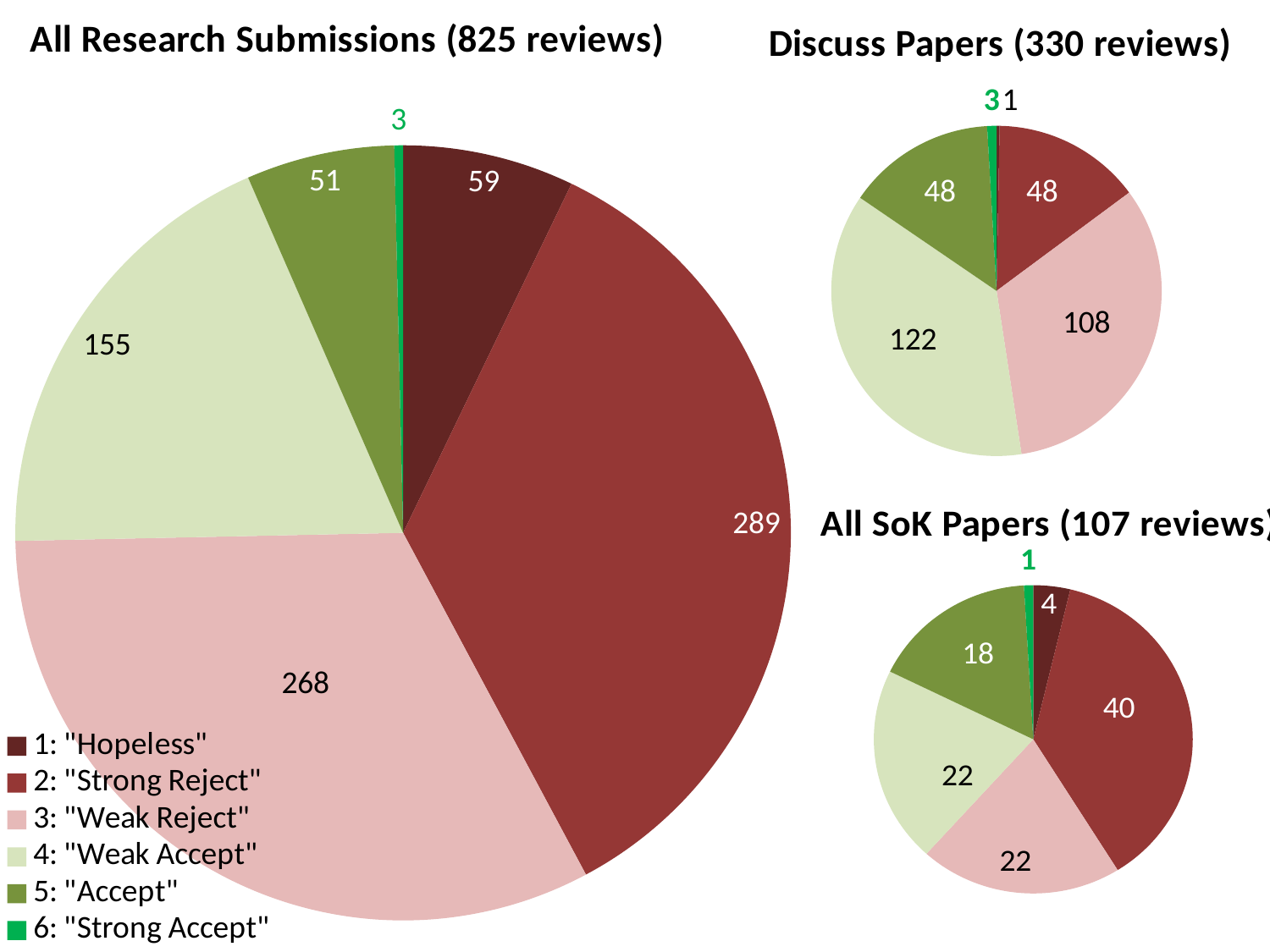
In the 'Discuss Papers (330 reviews)' pie chart, what is the value for 3: "Weak Reject"? 108 In the 'All Research Submissions (825 reviews)' pie chart, what is the difference between the values for 2: "Strong Reject" and 3: "Weak Reject"? 21 In the 'All SoK Papers (107 reviews)' pie chart, which is larger: 2: "Strong Reject" or 3: "Weak Reject"? 2: "Strong Reject" In the 'Discuss Papers (330 reviews)' pie chart, what is the difference between the values for 4: "Weak Accept" and 5: "Accept"? 74 In the 'All Research Submissions (825 reviews)' pie chart, what is the value for 4: "Weak Accept"? 155 In the 'All Research Submissions (825 reviews)' pie chart, which category has the smallest slice? 6: "Strong Accept" In the 'All SoK Papers (107 reviews)' pie chart, what is the value for 5: "Accept"? 18 How many pie charts are shown on the slide? 3 How many categories does the legend list for the pie charts? 6 In the 'Discuss Papers (330 reviews)' pie chart, which category has the largest slice? 4: "Weak Accept" What kind of chart is used for 'All SoK Papers (107 reviews)'? Pie chart In the 'All Research Submissions (825 reviews)' pie chart, what is the value for 2: "Strong Reject"? 289